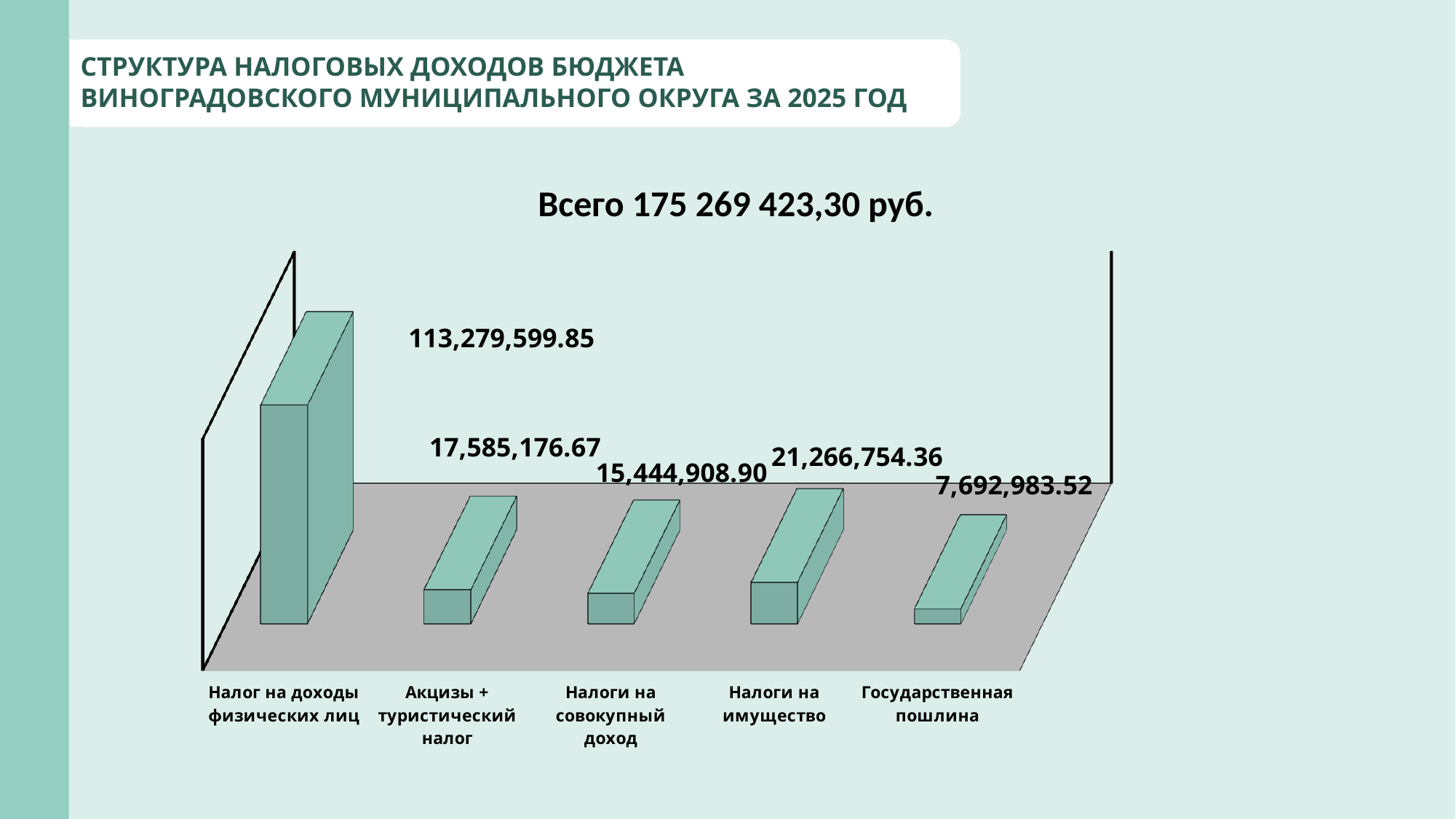
What is the value for Налоги на имущество? 21,266,754.36 What is the difference between the values for Акцизы + туристический налог and Налоги на совокупный доход? 2,140,267.77 What is the value for Государственная пошлина? 7,692,983.52 What is the difference between the values for Налоги на имущество and Акцизы + туристический налог? 3,681,577.69 What kind of chart is shown on the slide? Bar chart Which category has the lowest value? Государственная пошлина Which category has the highest value? Налог на доходы физических лиц How many categories are shown in the chart? 5 What is the value for Налог на доходы физических лиц? 113,279,599.85 Which is larger: the value for Налоги на имущество or the value for Налоги на совокупный доход? Налоги на имущество What is the value for Налоги на совокупный доход? 15,444,908.90 What is the value for Акцизы + туристический налог? 17,585,176.67